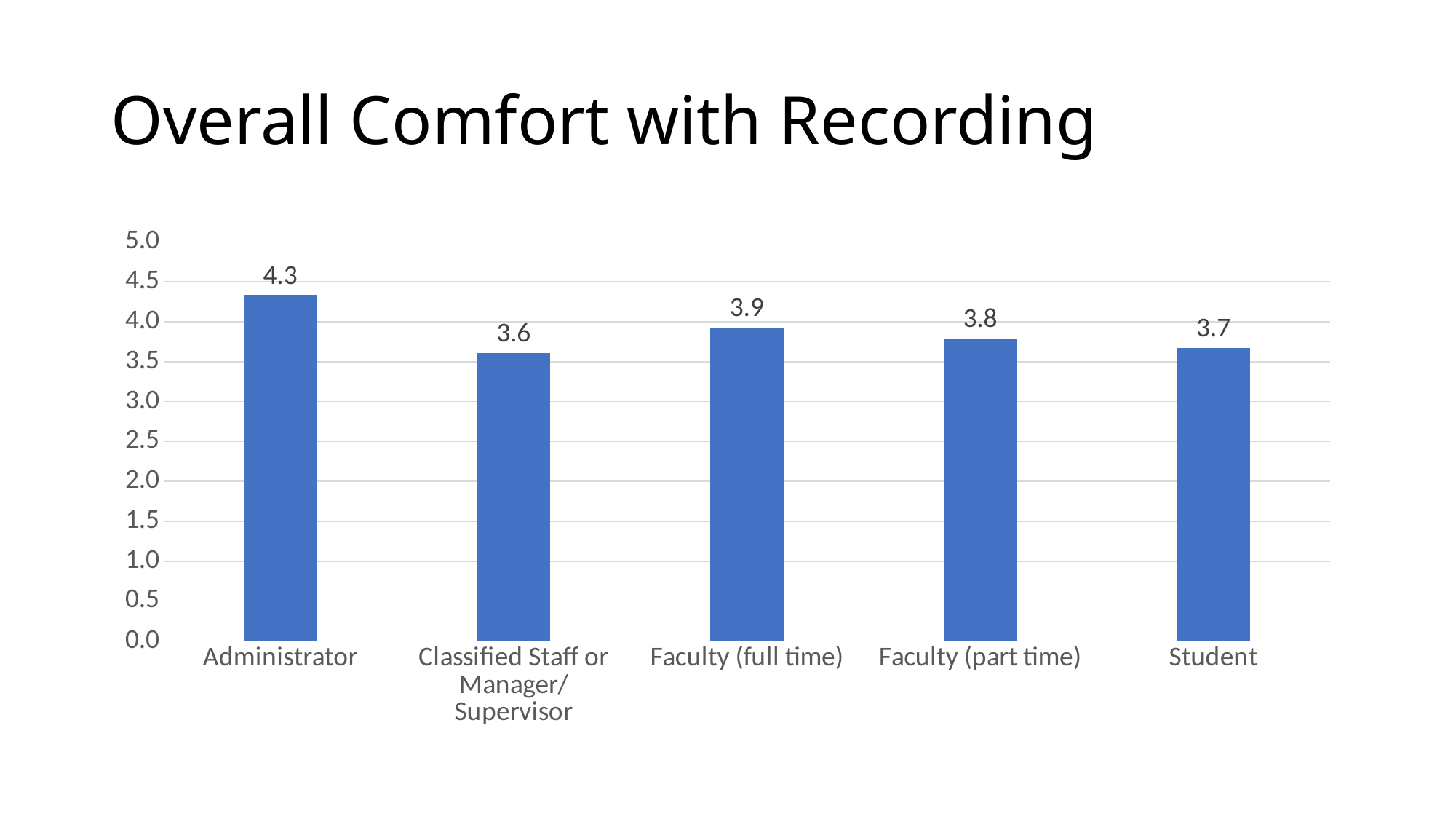
What kind of chart is shown on the slide? Bar chart What is the title of the slide? Overall Comfort with Recording What is the difference between the values for Administrator and Student? 0.6 What is the value for Faculty (full time)? 3.9 How many categories are shown on the chart? 5 Is the value for Administrator greater or less than 4.0? greater Which category has the lowest value? Classified Staff or Manager/Supervisor What is the value for Classified Staff or Manager/Supervisor? 3.6 What is the value for Student? 3.7 Which category has the highest value? Administrator What is the value for Administrator? 4.3 Which is larger, the value for Faculty (full time) or Faculty (part time)? Faculty (full time)